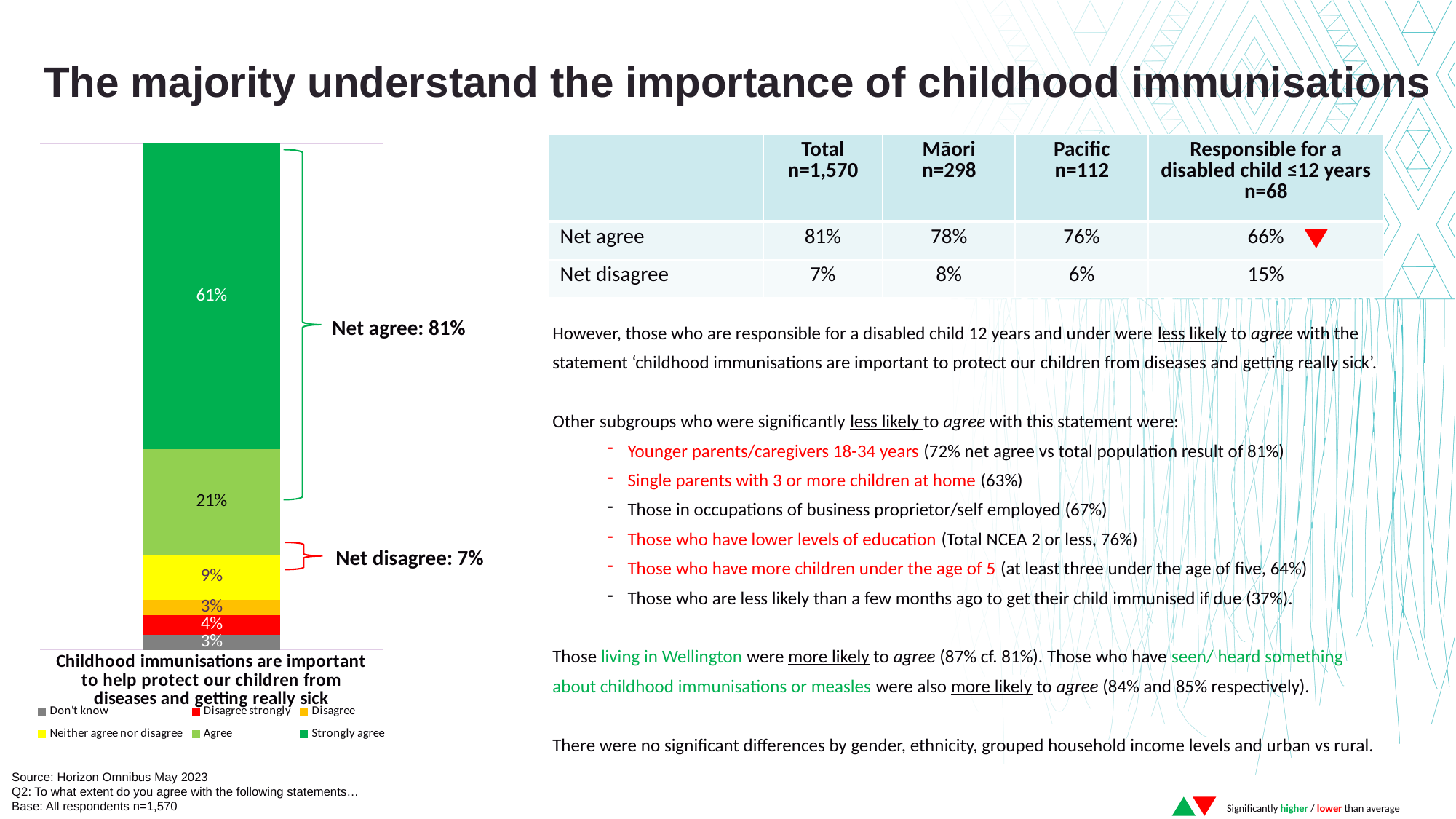
What percentage of respondents answered 'Disagree strongly'? 4% What percentage of respondents strongly agree that childhood immunisations are important to help protect our children from diseases and getting really sick? 61% What type of chart is shown on the left of the slide? Stacked bar chart Which is larger, the 'Disagree' share or the 'Disagree strongly' share? Disagree strongly What percentage of respondents chose 'Agree' in the stacked bar chart? 21% How many response categories does the chart legend list? 6 What is the difference between the 'Strongly agree' and 'Agree' percentages? 40 percentage points What is the combined 'Net agree' percentage shown next to the bar? 81% What is the 'Net disagree' percentage shown next to the bar? 7% What percentage of respondents answered 'Don't know'? 3% What percentage of respondents neither agree nor disagree with the statement? 9% Which response category has the largest share of the bar? Strongly agree